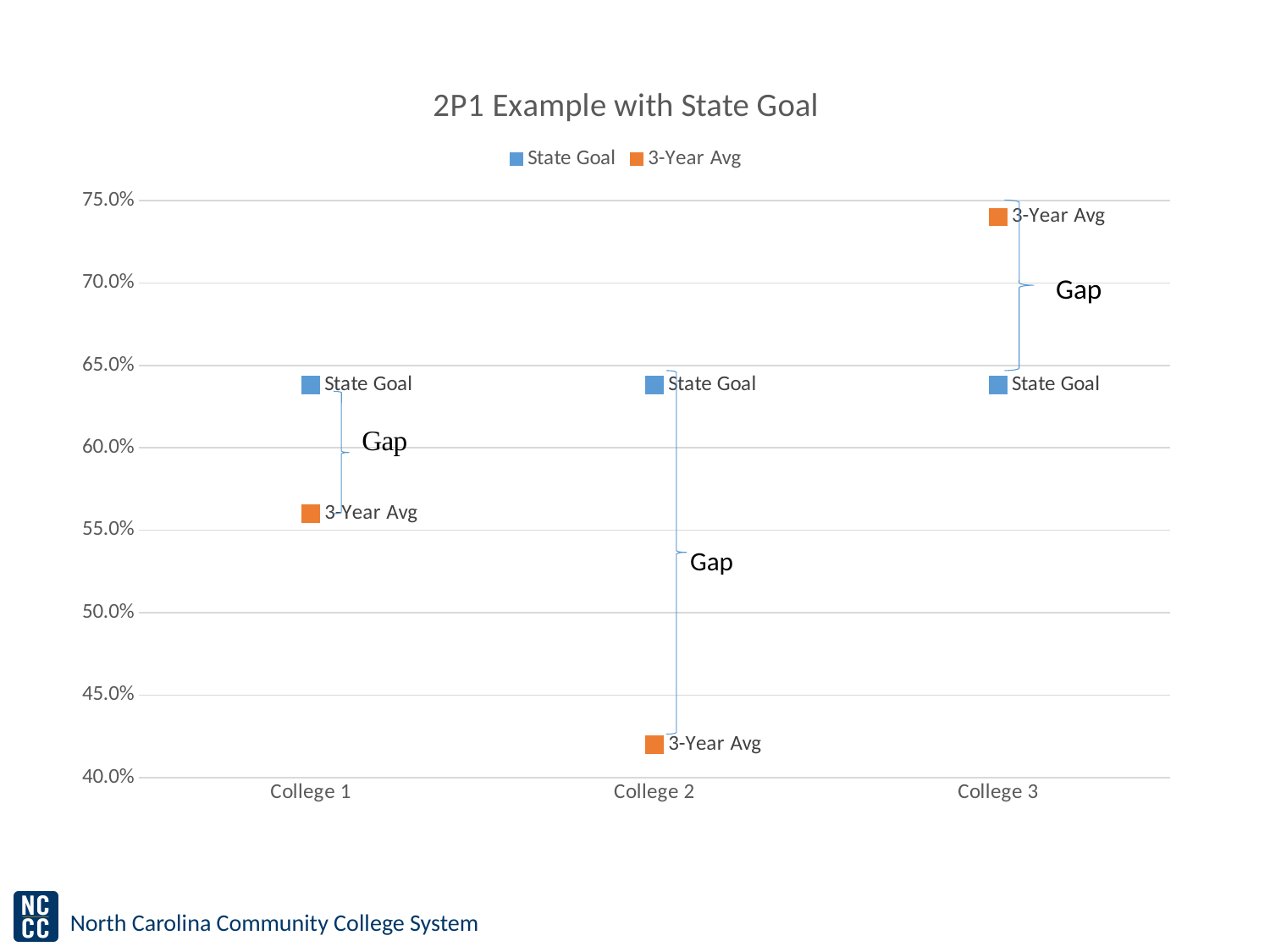
Is the State Goal value for College 1 greater or less than 65.0%? less For College 2, which is larger: the State Goal or the 3-Year Avg? State Goal What colour are the 3-Year Avg markers? Orange How many colleges are shown on the x axis? 3 How many series does the legend list? 2 What is the title of the chart? 2P1 Example with State Goal Is the 3-Year Avg value for College 3 greater or less than 70.0%? greater For College 3, which is larger: the State Goal or the 3-Year Avg? 3-Year Avg Which college has the highest 3-Year Avg? College 3 Is the 3-Year Avg value for College 1 greater or less than 55.0%? greater Which college has the lowest 3-Year Avg? College 2